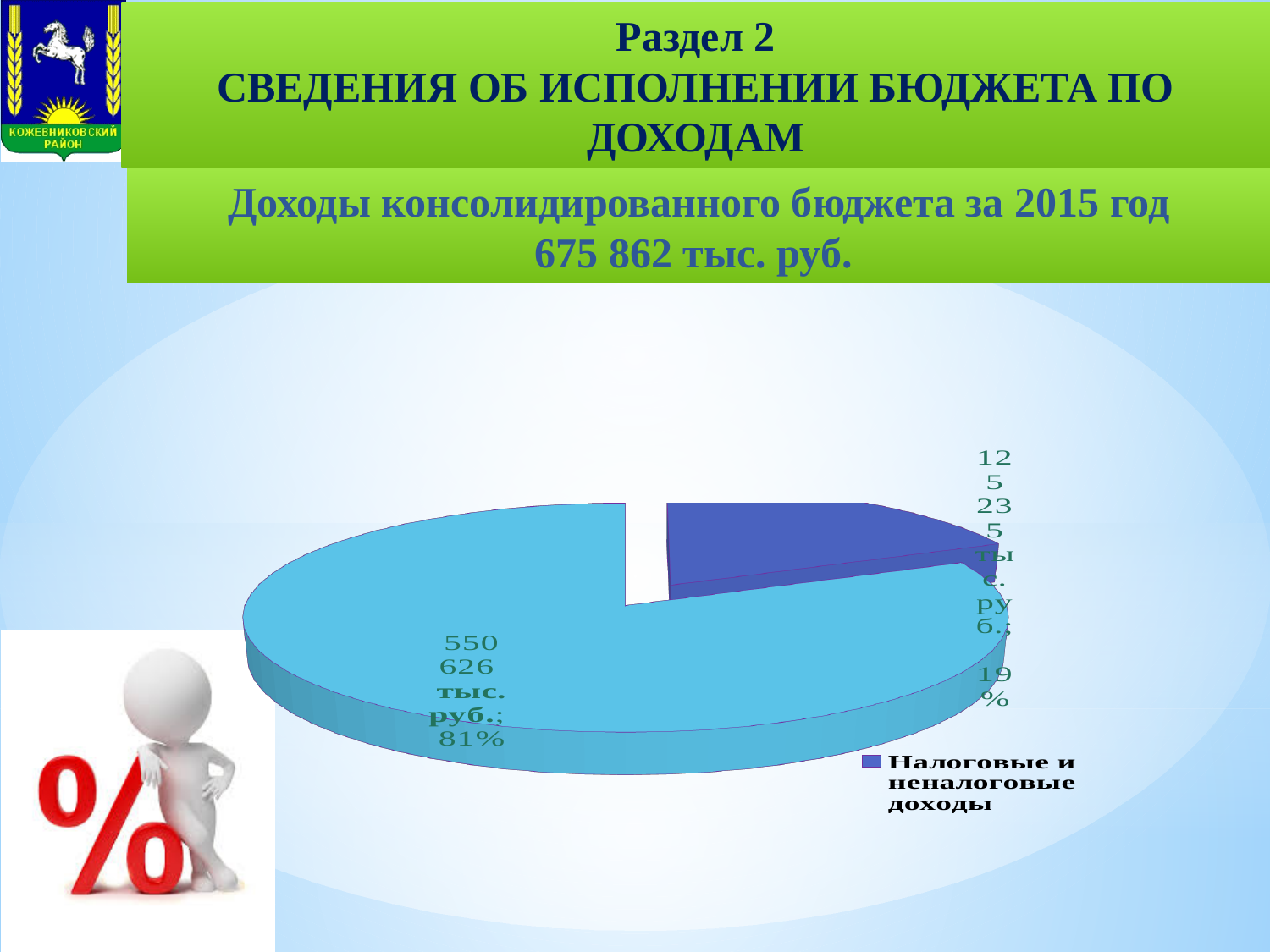
What value is printed on the large light blue slice? 550 626 тыс. руб. By how many percentage points does the light blue slice exceed the 'Налоговые и неналоговые доходы' slice? 62 percentage points What value is printed for the slice 'Налоговые и неналоговые доходы'? 125 235 тыс. руб. Is the slice 'Налоговые и неналоговые доходы' larger or smaller than the light blue slice? Smaller How many slices does the pie chart have? 2 What share of the pie does the slice 'Налоговые и неналоговые доходы' represent? 19% Which slice of the pie is the largest? The light blue slice (81%) What colour is the slice for 'Налоговые и неналоговые доходы'? Dark blue What share of the pie does the large light blue slice represent? 81% What type of chart is shown on the slide? Pie chart What is the difference in value between the light blue slice and the 'Налоговые и неналоговые доходы' slice? 425 391 тыс. руб. What legend entry is shown for the dark blue slice? Налоговые и неналоговые доходы